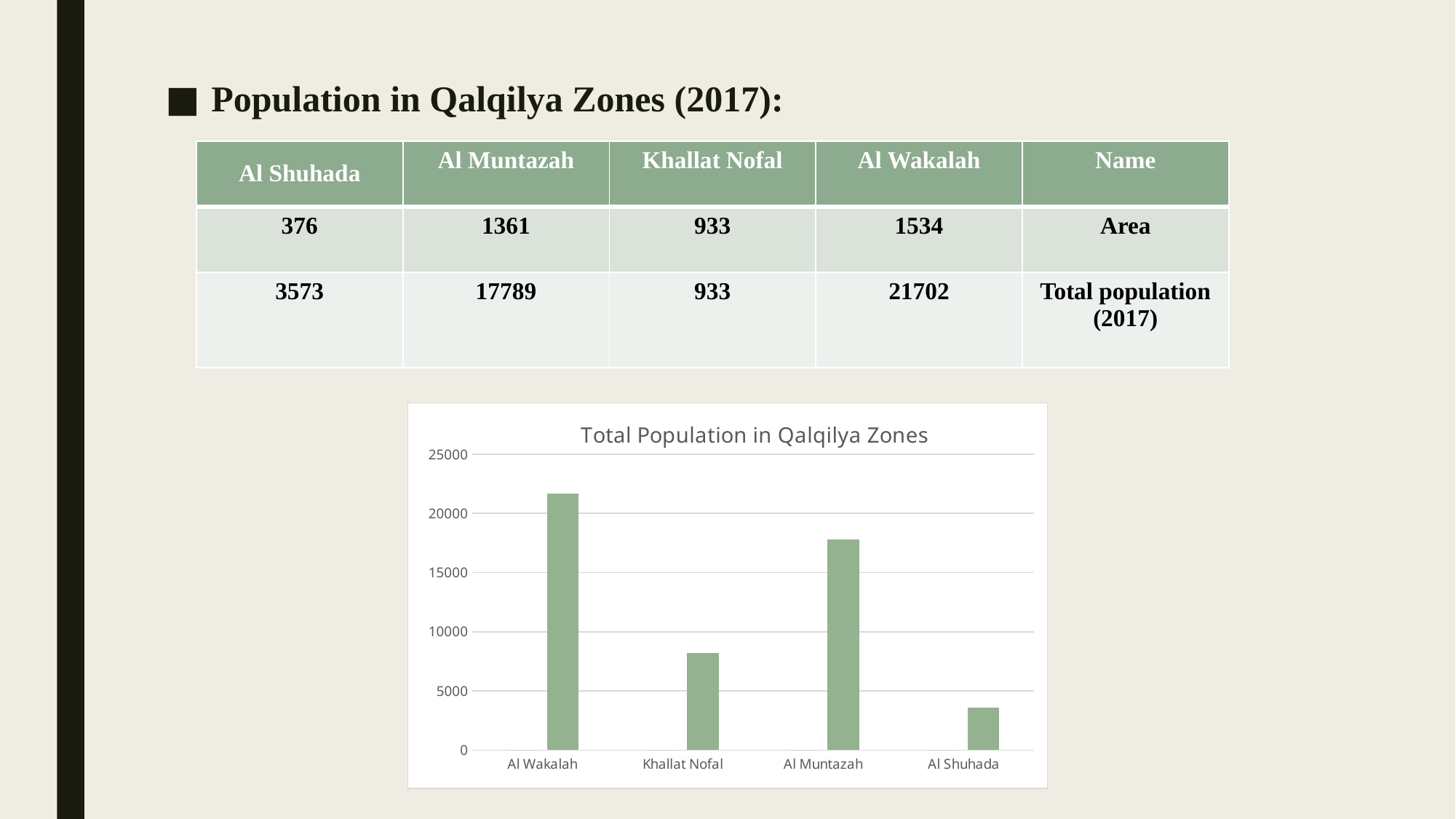
What kind of chart is shown on the slide? bar chart Is the value for Al Wakalah greater or less than 20000? greater Which has the larger bar, Al Muntazah or Khallat Nofal? Al Muntazah Which zone has the highest bar in the chart? Al Wakalah What is the title of the chart? Total Population in Qalqilya Zones Which has the larger bar, Al Wakalah or Al Muntazah? Al Wakalah Which zone has the lowest bar in the chart? Al Shuhada How many zones are plotted in the chart? 4 Is the value for Al Shuhada greater or less than 5000? less Is the value for Al Muntazah greater or less than 15000? greater What is the highest value shown on the chart's vertical axis? 25000